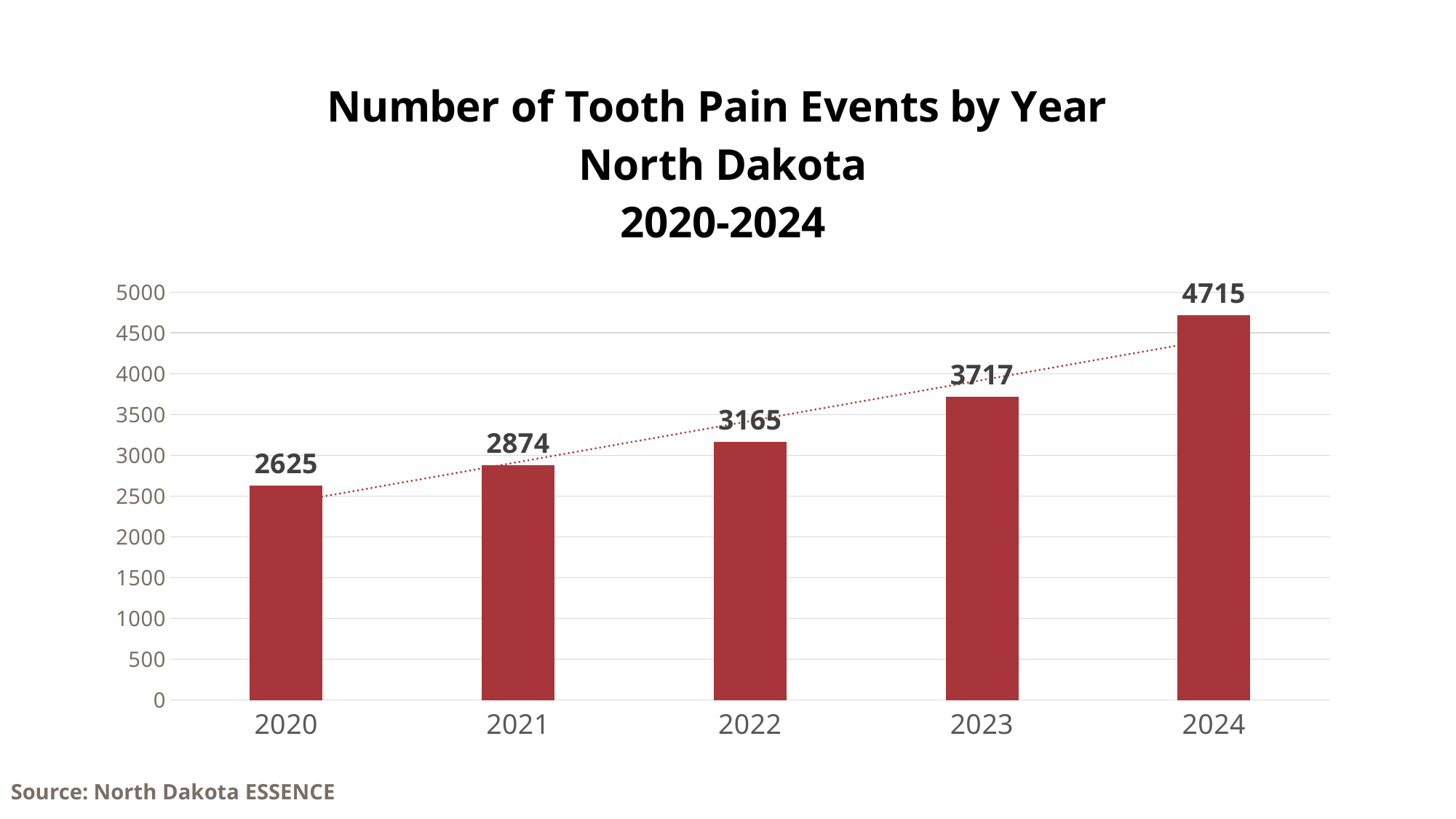
What kind of chart is shown on the slide? bar chart Is the value for 2022 greater or less than 3000? greater What is the difference in tooth pain events between 2024 and 2023? 998 Which year had more tooth pain events, 2021 or 2023? 2023 What is the number of tooth pain events for 2022? 3165 What is the value shown for 2024? 4715 How many tooth pain events were recorded in 2020? 2625 What is the difference in tooth pain events between 2021 and 2020? 249 Which year has the highest number of tooth pain events? 2024 How many years are shown on the x axis? 5 Which year has the lowest number of tooth pain events? 2020 Do the number of tooth pain events rise or fall from 2020 to 2024? rise